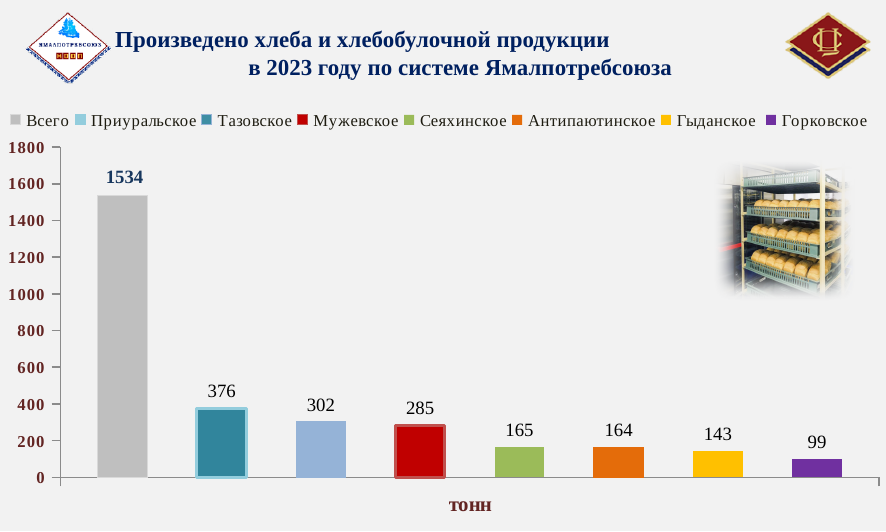
What kind of chart is shown on the slide? bar chart What is the difference between the values for Мужевское and Гыданское? 142 What is the value for Горковское? 99 What is the value for Мужевское? 285 Is the value for Всего greater or less than 1400? greater How many bars are plotted on the chart? 8 Which category has the highest value? Всего What is the value for Всего? 1534 Which category has the lowest value? Горковское Which is larger, the value for Мужевское or the value for Гыданское? Мужевское What is the value for Гыданское? 143 What is the value for Сеяхинское? 165